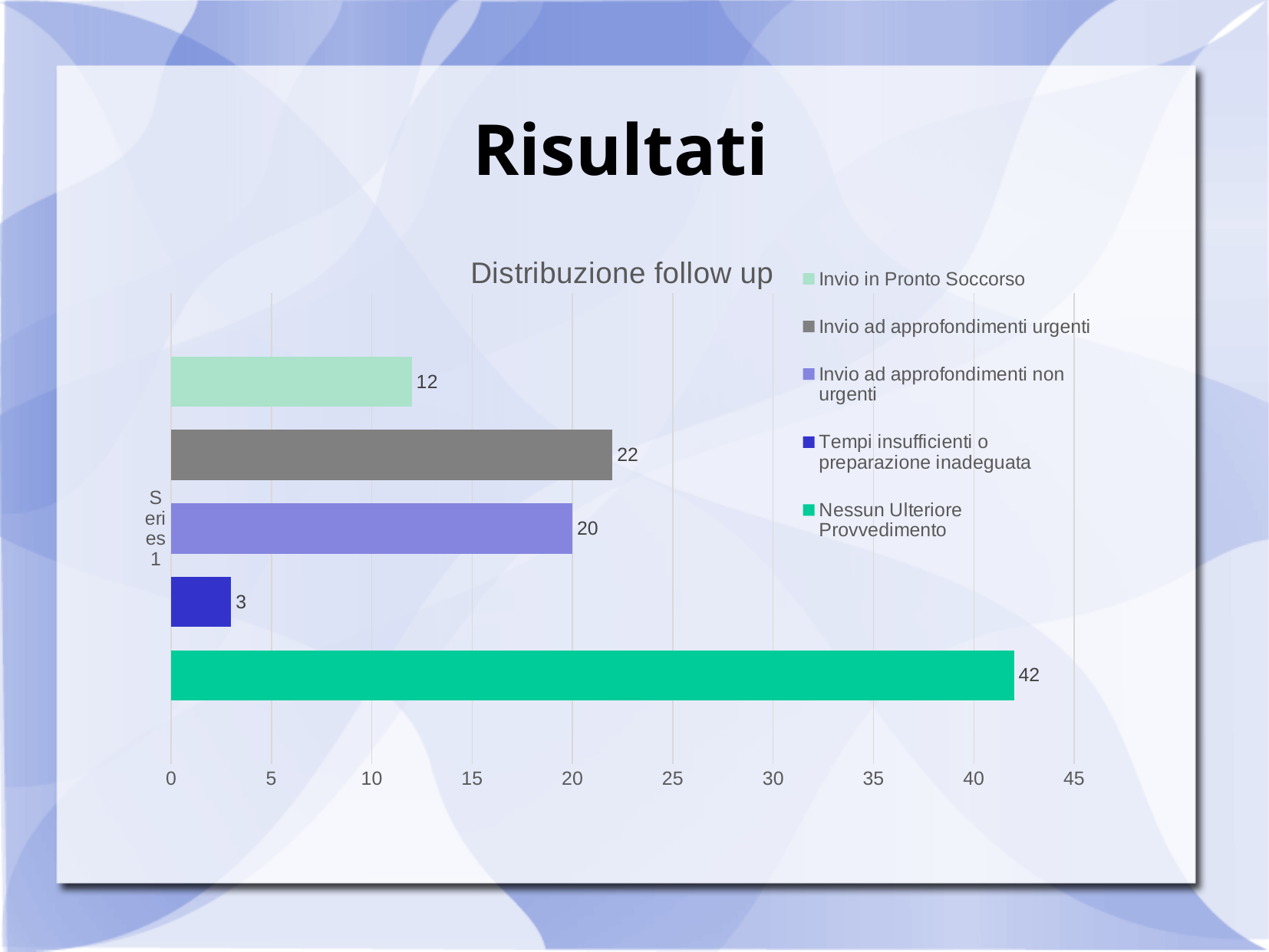
How many series does the legend list? 5 Which series has the lowest value? Tempi insufficienti o preparazione inadeguata What is the title of the chart? Distribuzione follow up Is the value for Invio ad approfondimenti non urgenti greater or less than 15? greater What is the value for Invio ad approfondimenti urgenti? 22 What is the difference between Nessun Ulteriore Provvedimento and Invio ad approfondimenti urgenti? 20 Which is larger: Invio ad approfondimenti urgenti or Invio ad approfondimenti non urgenti? Invio ad approfondimenti urgenti What is the value for Nessun Ulteriore Provvedimento? 42 What is the value for Tempi insufficienti o preparazione inadeguata? 3 What kind of chart is shown? bar chart Which series has the highest value? Nessun Ulteriore Provvedimento What is the value for Invio in Pronto Soccorso? 12